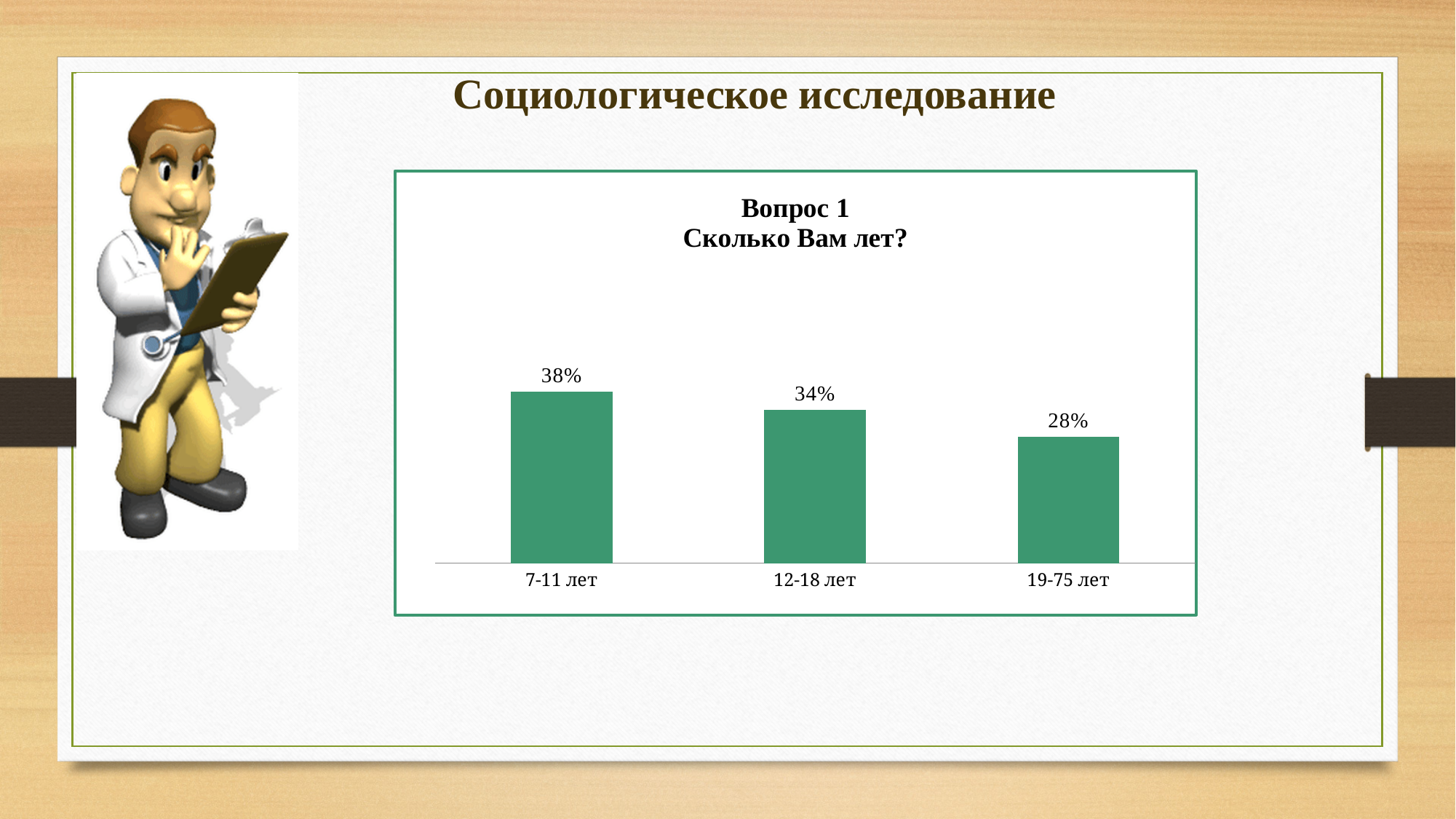
What is the difference between the values for 7-11 лет and 12-18 лет? 4% How many age categories are shown in the chart? 3 What is the value for the 19-75 лет category? 28% What is the value for the 12-18 лет category? 34% Which age category has the lowest value? 19-75 лет What is the difference between the values for 7-11 лет and 19-75 лет? 10% Which is larger, the value for 12-18 лет or the value for 19-75 лет? 12-18 лет What is the value for the 7-11 лет category? 38% Which age category has the highest value? 7-11 лет What kind of chart is shown on the slide? Bar chart Do the values rise or fall from left to right across the categories? Fall What is the title of the chart? Вопрос 1 Сколько Вам лет?